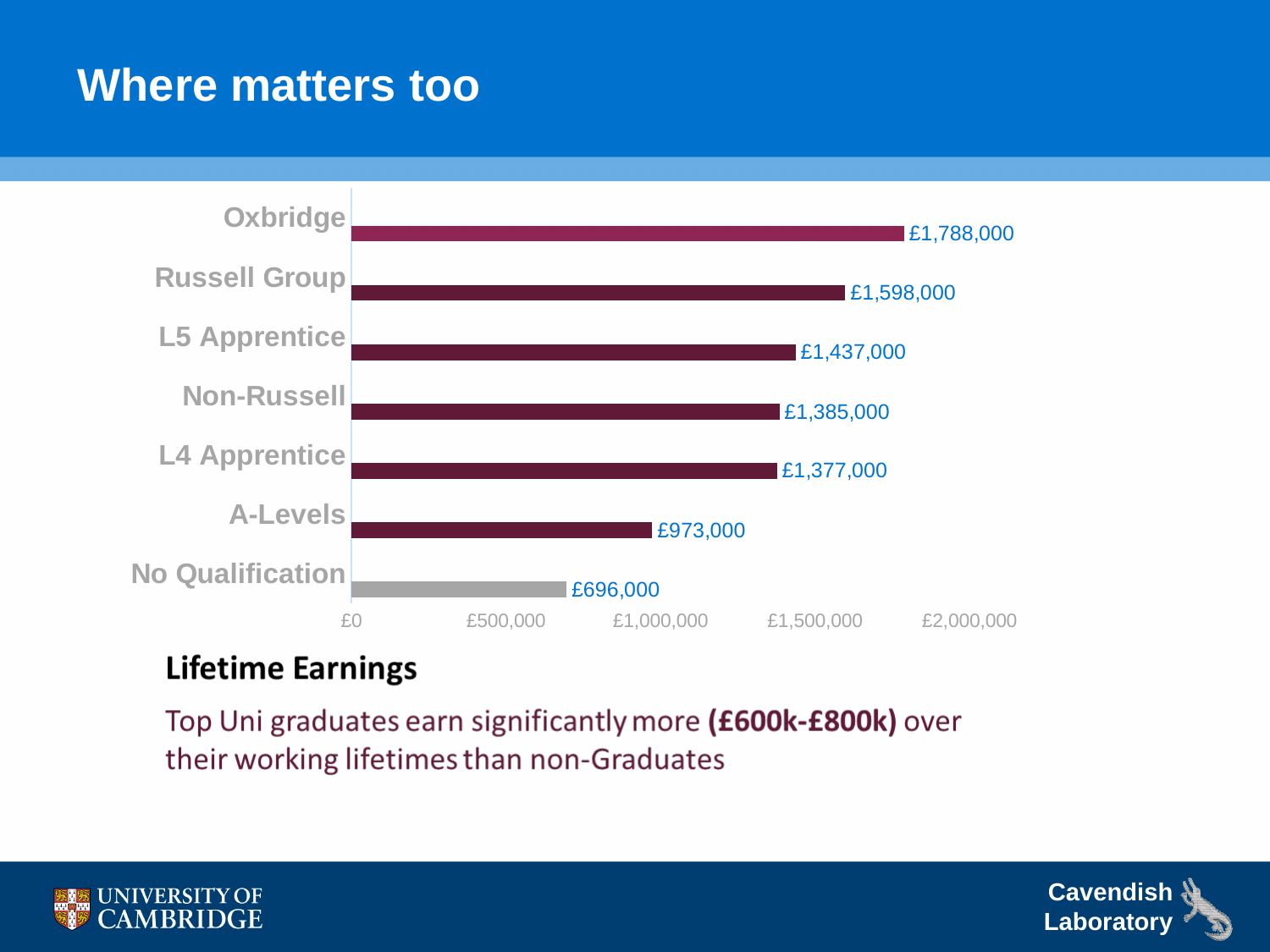
How many categories are shown in the chart? 7 What is the difference in lifetime earnings between A-Levels and No Qualification? £277,000 What is the difference in lifetime earnings between Oxbridge and Russell Group? £190,000 Which bar is coloured grey rather than dark red? No Qualification Which has higher lifetime earnings, Russell Group or Non-Russell? Russell Group Which category has the lowest lifetime earnings? No Qualification Is the value for A-Levels greater or less than £1,000,000? less What is the lifetime earnings value for L5 Apprentice? £1,437,000 What is the lifetime earnings value for Oxbridge? £1,788,000 Which category has the highest lifetime earnings? Oxbridge What kind of chart is shown on the slide? Bar chart What is the lifetime earnings value for No Qualification? £696,000